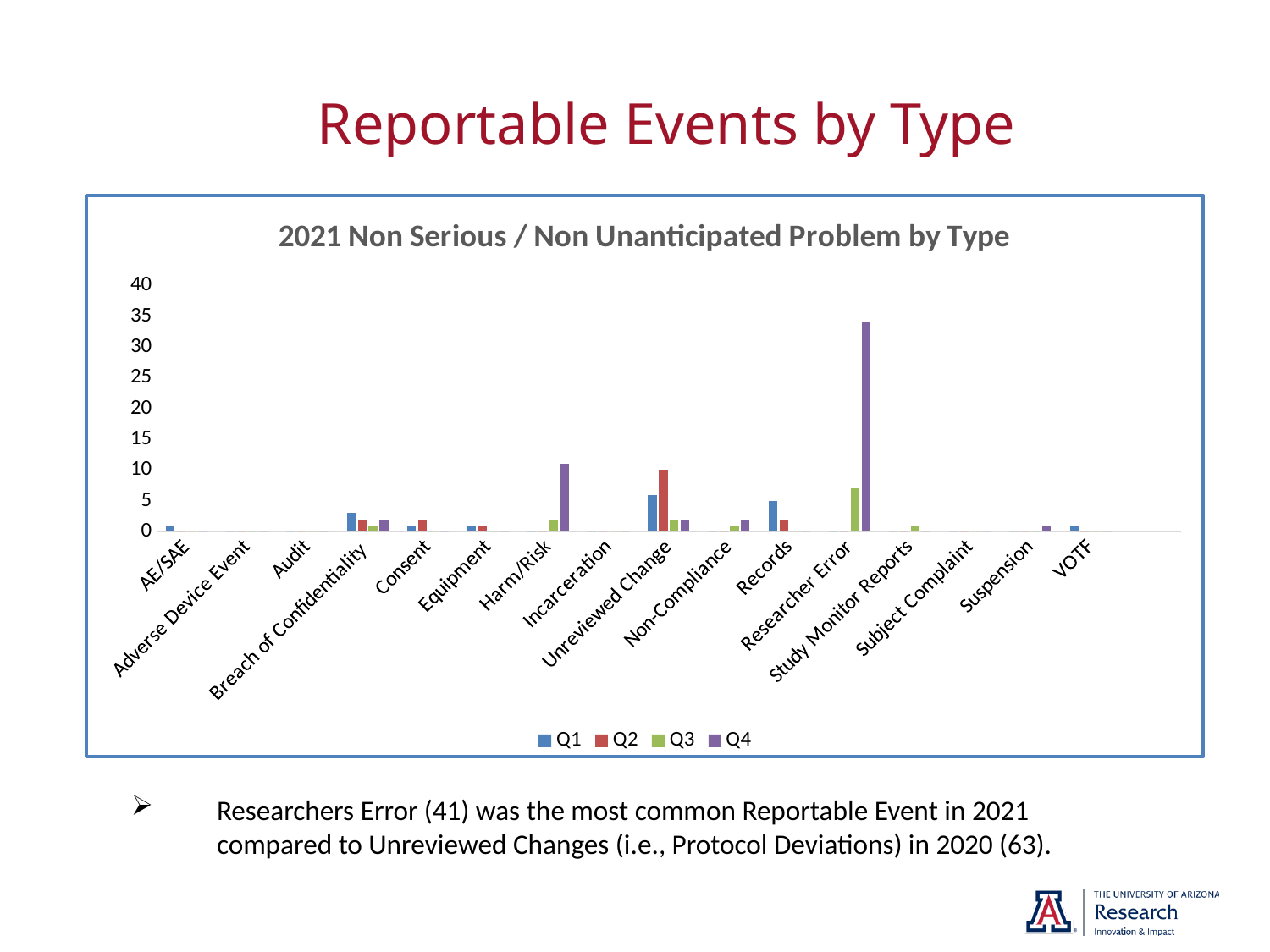
Which category has the tallest bar in the chart? Researcher Error Which series has the tallest bar for Researcher Error? Q4 How many categories are shown along the x axis? 16 How many series does the legend list? 4 Is the Q4 value for Researcher Error greater or less than 30? greater What kind of chart is shown on the slide? bar chart Is the Q4 value for Harm/Risk greater or less than 5? greater Is the Q2 value for Unreviewed Change greater or less than 5? greater Which is larger: the Q4 value for Researcher Error or the Q4 value for Harm/Risk? Researcher Error What is the title of the chart? 2021 Non Serious / Non Unanticipated Problem by Type Which series is shown in purple in the legend? Q4